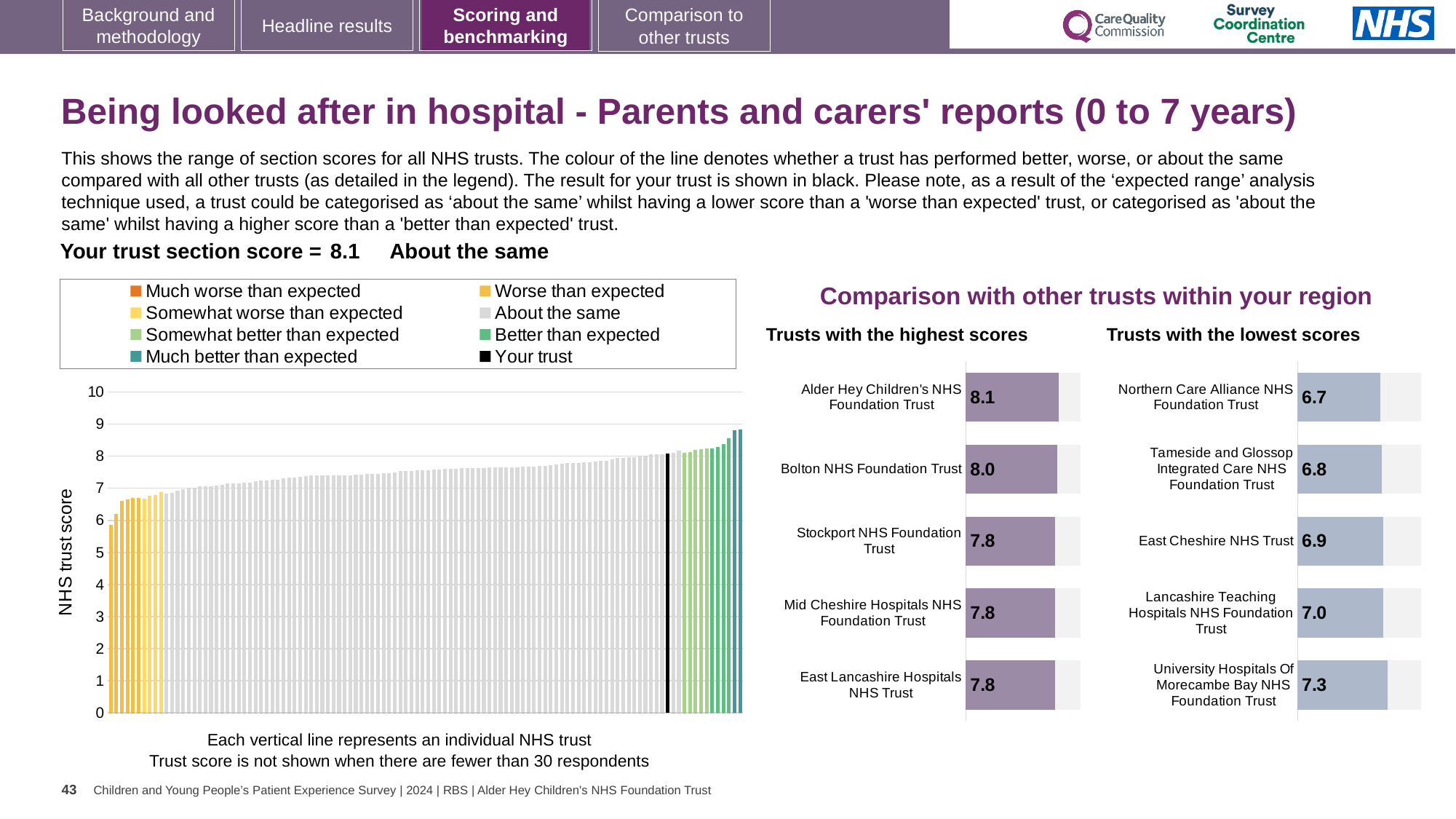
In the 'Trusts with the lowest scores' chart, which has the larger score: Lancashire Teaching Hospitals NHS Foundation Trust or University Hospitals Of Morecambe Bay NHS Foundation Trust? University Hospitals Of Morecambe Bay NHS Foundation Trust In the 'Trusts with the lowest scores' chart, which trust has the lowest score? Northern Care Alliance NHS Foundation Trust In the main chart on the left, is the highest bar greater or less than 8? greater In the main chart on the left, what is the label on the vertical axis? NHS trust score In the 'Trusts with the lowest scores' chart, what is the score for East Cheshire NHS Trust? 6.9 In the main chart on the left, do the bar values rise or fall from left to right? rise How many trusts are shown in the 'Trusts with the highest scores' chart? 5 What kind of chart is the main chart on the left showing NHS trust scores? bar chart In the 'Trusts with the highest scores' chart, which trust has the highest score? Alder Hey Children's NHS Foundation Trust In the 'Trusts with the highest scores' chart, what is the difference between the scores of Alder Hey Children's NHS Foundation Trust and Stockport NHS Foundation Trust? 0.3 How many entries does the legend above the main chart on the left list? 8 In the 'Trusts with the highest scores' chart, what is the score for Bolton NHS Foundation Trust? 8.0